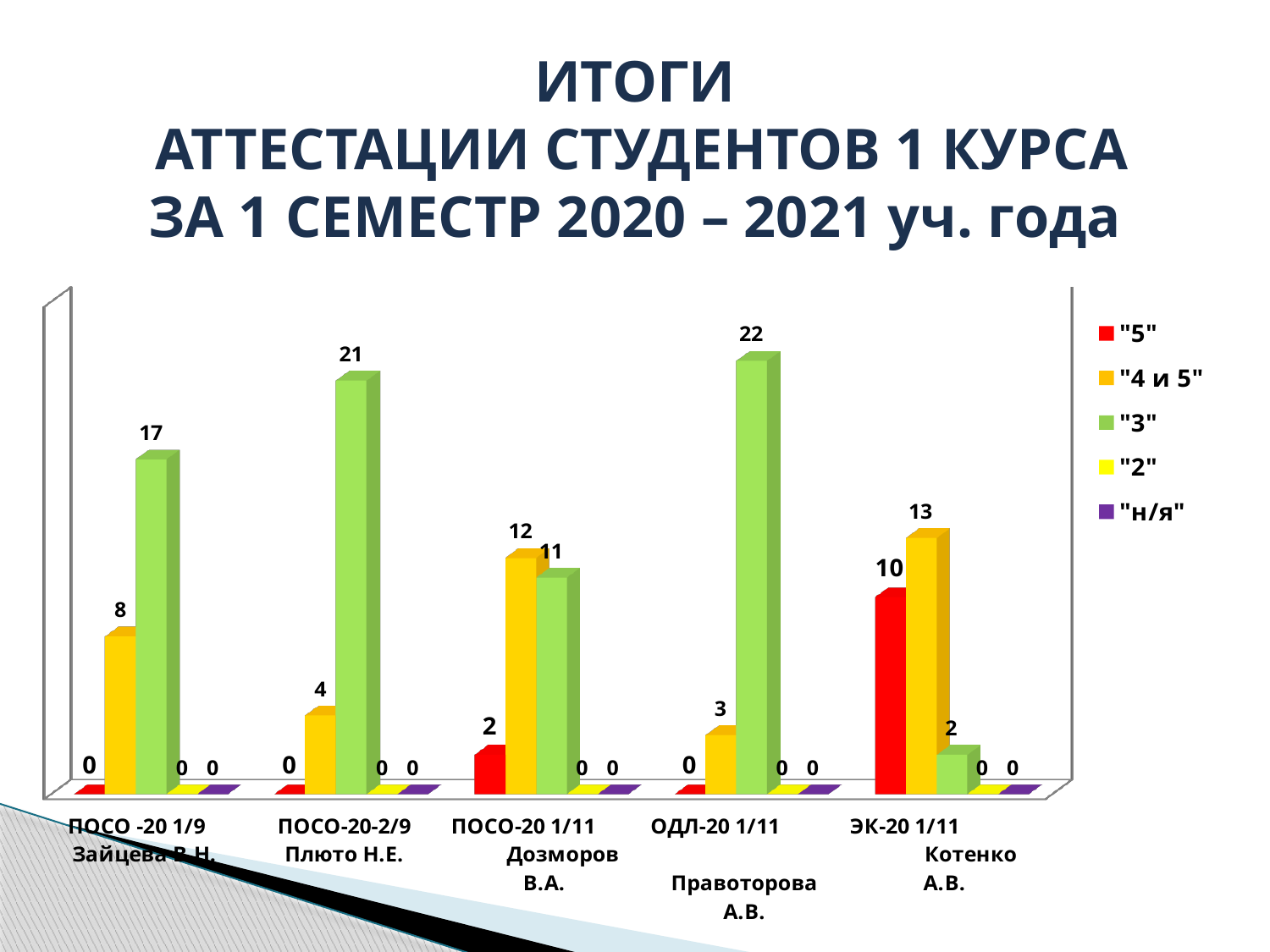
What colour represents the "2" series in the legend? yellow What type of chart is shown on the slide? bar chart What is the value of the "3" series for ОДЛ-20 1/11 (Правоторова А.В.)? 22 For ПОСО-20 1/11 (Дозморов В.А.), which is larger: the "4 и 5" value or the "3" value? "4 и 5" What is the value of the "5" series for ПОСО-20 1/11 (Дозморов В.А.)? 2 How many series does the legend list? 5 Which group has the highest value in the "3" series? ОДЛ-20 1/11 (Правоторова А.В.) Which group has the highest value in the "5" series? ЭК-20 1/11 (Котенко А.В.) Which group has the lowest value in the "4 и 5" series? ОДЛ-20 1/11 (Правоторова А.В.) What is the value of the "4 и 5" series for ЭК-20 1/11 (Котенко А.В.)? 13 How many groups (categories) are shown on the x axis? 5 What is the difference between the "3" values for ПОСО-20-2/9 (Плюто Н.Е.) and ПОСО-20 1/9 (Зайцева В.Н.)? 4